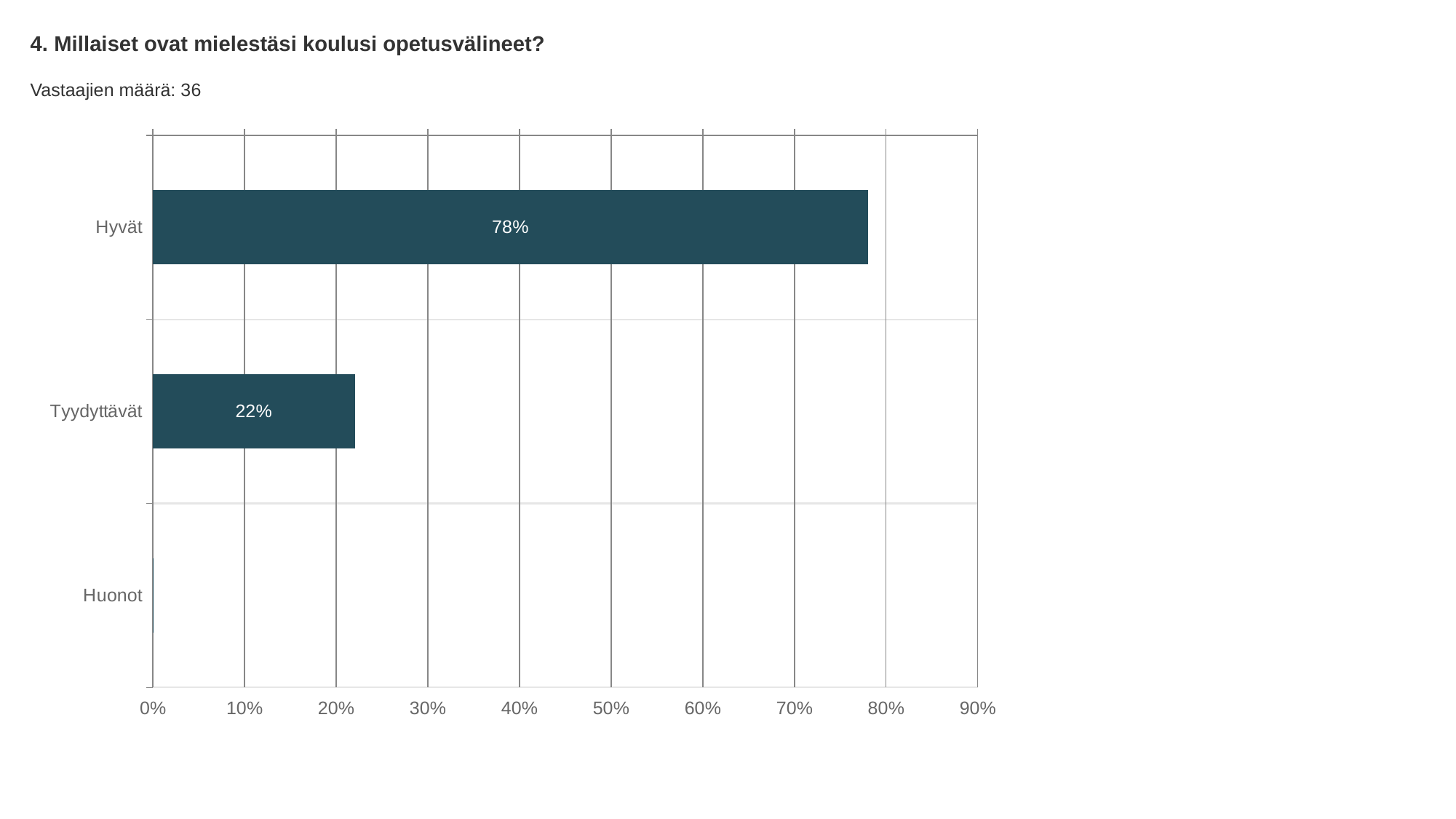
How many respondents (Vastaajien määrä) are reported on the slide? 36 Is the value for Hyvät greater or less than 70%? greater Which category has the highest value? Hyvät Is the value for Tyydyttävät greater or less than 30%? less What is the value for Tyydyttävät? 22% What kind of chart is shown on the slide? bar chart What is the value for Hyvät? 78% What is the title of the chart? 4. Millaiset ovat mielestäsi koulusi opetusvälineet? Which is larger, the value for Hyvät or the value for Tyydyttävät? Hyvät How many categories are shown in the chart? 3 What is the difference between the values for Hyvät and Tyydyttävät? 56% Which category has the lowest value? Huonot